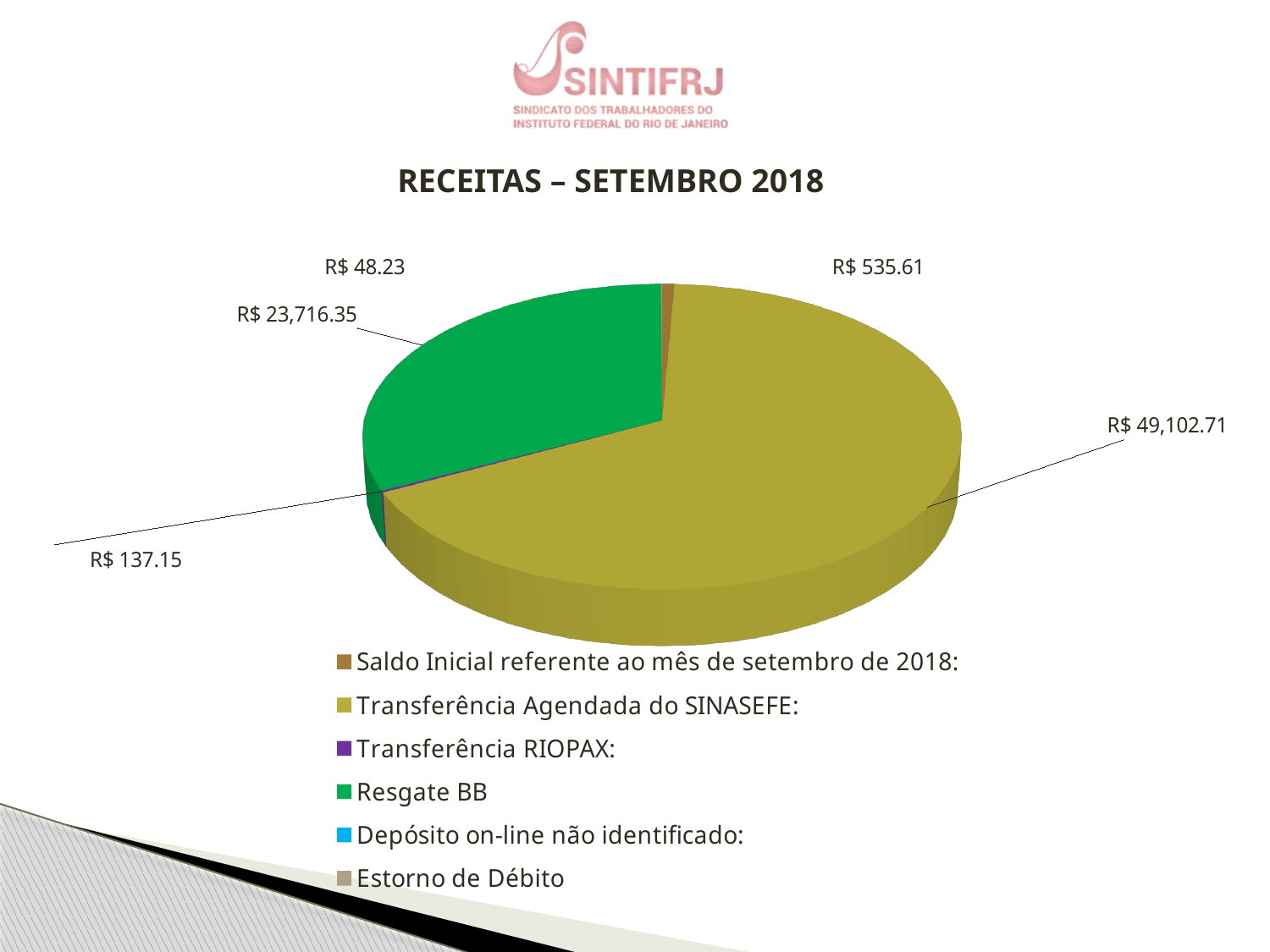
What is the value for Resgate BB? R$ 23,716.35 Which is larger, Transferência Agendada do SINASEFE or Resgate BB? Transferência Agendada do SINASEFE What colour is the Resgate BB slice? green What is the title of the chart? RECEITAS – SETEMBRO 2018 What is the difference between Transferência Agendada do SINASEFE and Resgate BB? R$ 25,386.36 How many entries does the chart's legend list? 6 What is the value for Saldo Inicial referente ao mês de setembro de 2018? R$ 535.61 Which category has the largest slice of the pie? Transferência Agendada do SINASEFE What kind of chart is shown on the slide? pie chart What is the smallest value printed on the chart? R$ 48.23 What is the value for Transferência RIOPAX? R$ 137.15 What is the value for Transferência Agendada do SINASEFE? R$ 49,102.71